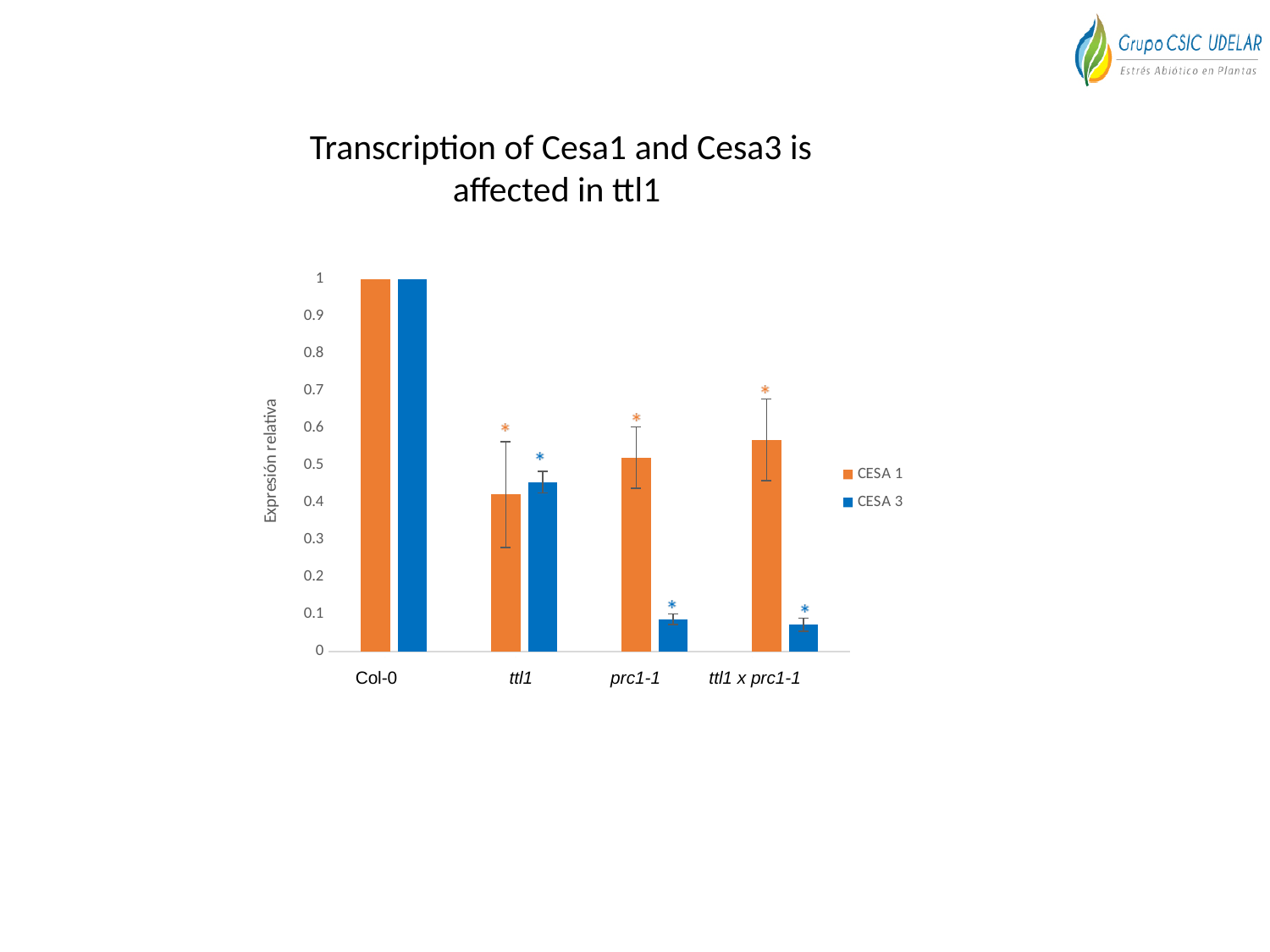
What is the value of CESA 3 for Col-0? 1 How many categories are shown on the x axis? 4 What kind of chart is shown on the slide? bar chart Is the value of CESA 1 for ttl1 x prc1-1 greater or less than 0.5? greater Which category has the lowest value for CESA 1? ttl1 What is the title of the y axis? Expresión relativa For prc1-1, which series has the larger value, CESA 1 or CESA 3? CESA 1 Is the value of CESA 3 for prc1-1 greater or less than 0.2? less Is the value of CESA 1 for ttl1 greater or less than 0.5? less Which category has the highest value for CESA 3? Col-0 How many series does the legend list? 2 What is the value of CESA 1 for Col-0? 1